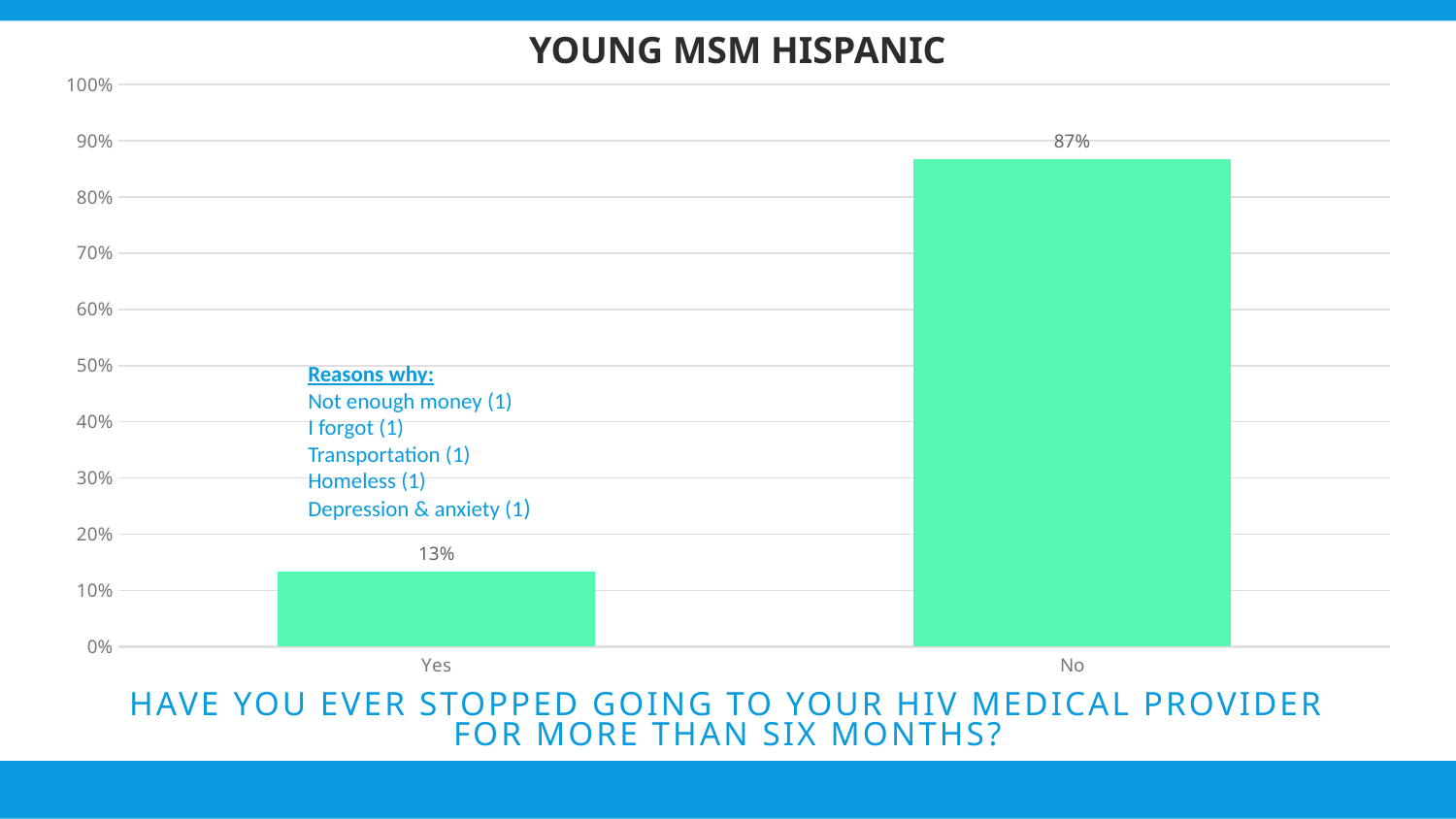
What kind of chart is shown on the slide? bar chart Is the value for No greater or less than 80%? greater What is the title of the chart? YOUNG MSM HISPANIC What is the difference between the values for No and Yes? 74% What is the value for No? 87% Is the value for Yes greater or less than 20%? less What is the value for Yes? 13% Which category has the highest value? No Which is larger, the value for Yes or the value for No? No How many categories are shown on the x axis? 2 What is the total of the values for Yes and No? 100% Which category has the lowest value? Yes